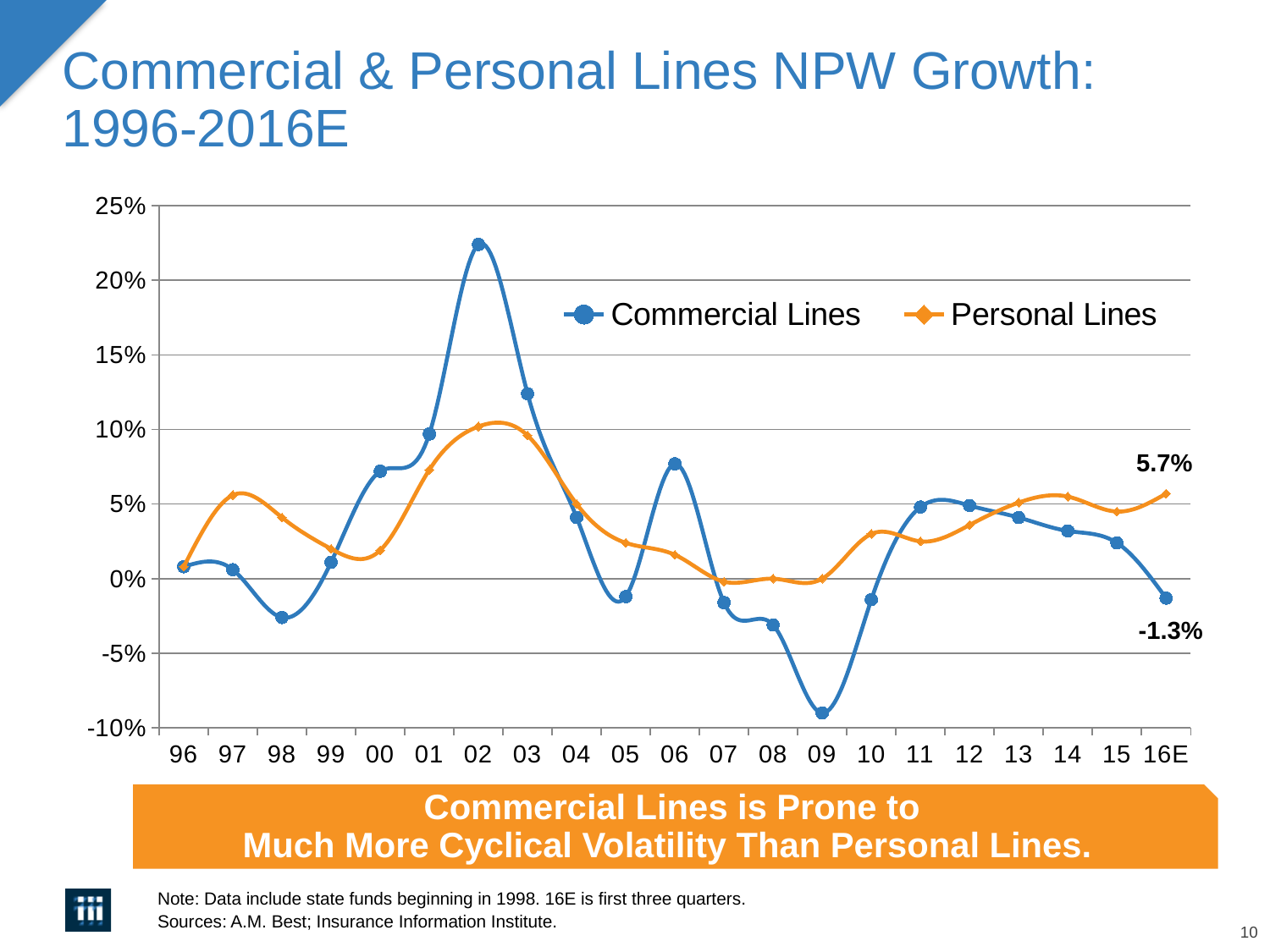
What is the Personal Lines NPW growth value for 16E? 5.7% Is the Commercial Lines value for 09 greater or less than -5%? less What is the Commercial Lines NPW growth value for 16E? -1.3% What is the difference between the Personal Lines and Commercial Lines values for 16E? 7.0 percentage points What kind of chart is shown on the slide? Line chart For 16E, which series has the higher value, Commercial Lines or Personal Lines? Personal Lines In which year does Commercial Lines reach its highest value? 02 Is the Commercial Lines value for 02 greater or less than 20%? greater In which year does Commercial Lines reach its lowest value? 09 How many years are shown along the x axis? 21 Does the Commercial Lines series rise or fall from 11 to 16E? Fall How many series does the legend list? 2